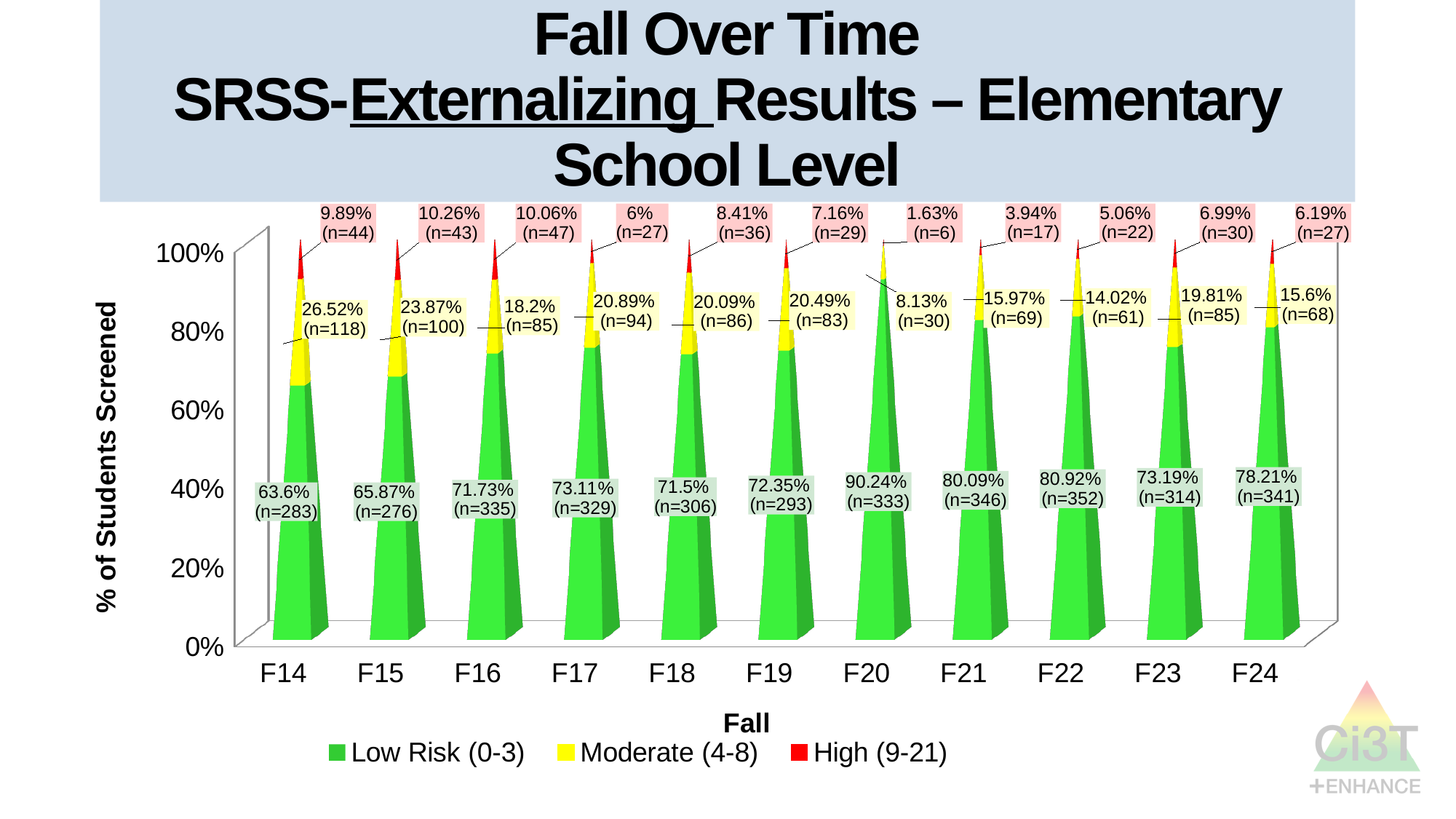
How many students were in the Moderate (4-8) category in F24? 68 What kind of chart is shown on the slide? Stacked bar chart Which has the larger Moderate (4-8) percentage, F14 or F16? F14 Which fall has the lowest Low Risk (0-3) percentage? F14 Which fall has the lowest High (9-21) percentage? F20 What percentage of students screened were High (9-21) in F15? 10.26% What percentage of students screened were Low Risk (0-3) in F20? 90.24% What is the label of the y axis? % of Students Screened Which fall has the highest Low Risk (0-3) percentage? F20 What is the difference in percentage points between the Low Risk (0-3) value in F20 and in F14? 26.64 How many fall time points are shown on the x axis? 11 How many series does the legend list? 3